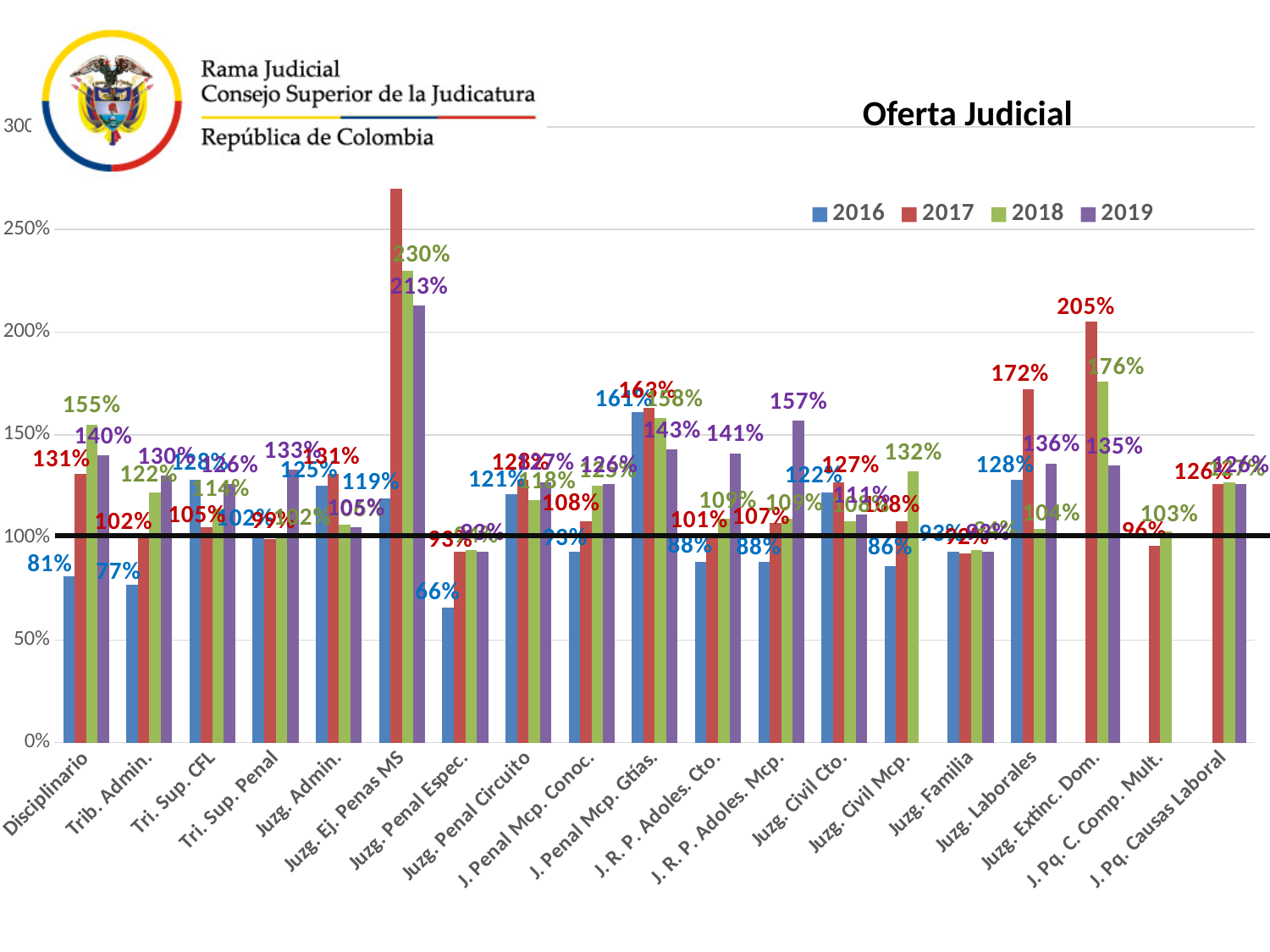
What is the title of the chart? Oferta Judicial What is the 2018 value for Juzg. Ej. Penas MS? 230% What is the 2016 value for Disciplinario? 81% What is the difference between the 2017 and 2018 values for Juzg. Extinc. Dom.? 29 percentage points What is the 2019 value for J. R. P. Adoles. Mcp.? 157% Which category has the lowest 2016 value? Juzg. Penal Espec. How many categories are shown on the x axis? 19 Is the 2017 value for Juzg. Ej. Penas MS greater or less than 250%? greater What kind of chart is shown on the slide? Bar chart Which category has the highest 2017 value? Juzg. Ej. Penas MS How many series does the legend list? 4 What is the 2017 value for Juzg. Extinc. Dom.? 205%